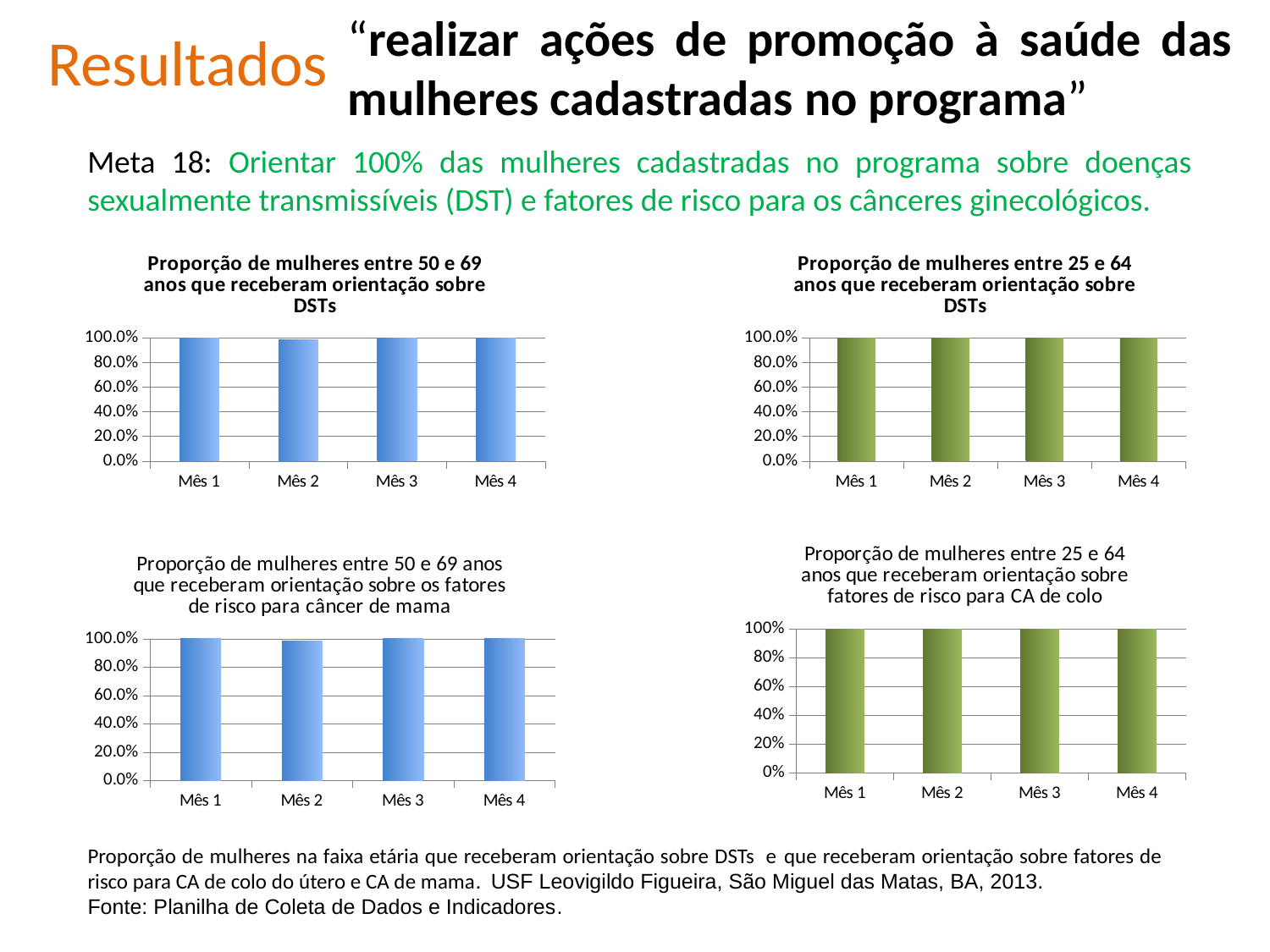
How many charts are shown on the slide? 4 In the top-left chart, 'Proporção de mulheres entre 50 e 69 anos que receberam orientação sobre DSTs', what is the highest value shown on the y axis? 100.0% In the top-left chart, 'Proporção de mulheres entre 50 e 69 anos que receberam orientação sobre DSTs', how many months are plotted on the x axis? 4 In the bottom-left chart, 'Proporção de mulheres entre 50 e 69 anos que receberam orientação sobre os fatores de risco para câncer de mama', is the value for Mês 3 greater or less than 60.0%? greater In the top-right chart, 'Proporção de mulheres entre 25 e 64 anos que receberam orientação sobre DSTs', is the value for Mês 1 greater or less than 80.0%? greater What colour are the bars in the top-right chart, 'Proporção de mulheres entre 25 e 64 anos que receberam orientação sobre DSTs'? Green In the top-left chart, 'Proporção de mulheres entre 50 e 69 anos que receberam orientação sobre DSTs', is the value for Mês 4 greater or less than 60.0%? greater What is the label of the first category on the x axis of the bottom-left chart, 'Proporção de mulheres entre 50 e 69 anos que receberam orientação sobre os fatores de risco para câncer de mama'? Mês 1 What kind of chart is the top-left chart, 'Proporção de mulheres entre 50 e 69 anos que receberam orientação sobre DSTs'? Bar chart In the bottom-right chart, 'Proporção de mulheres entre 25 e 64 anos que receberam orientação sobre fatores de risco para CA de colo', how many bars are plotted? 4